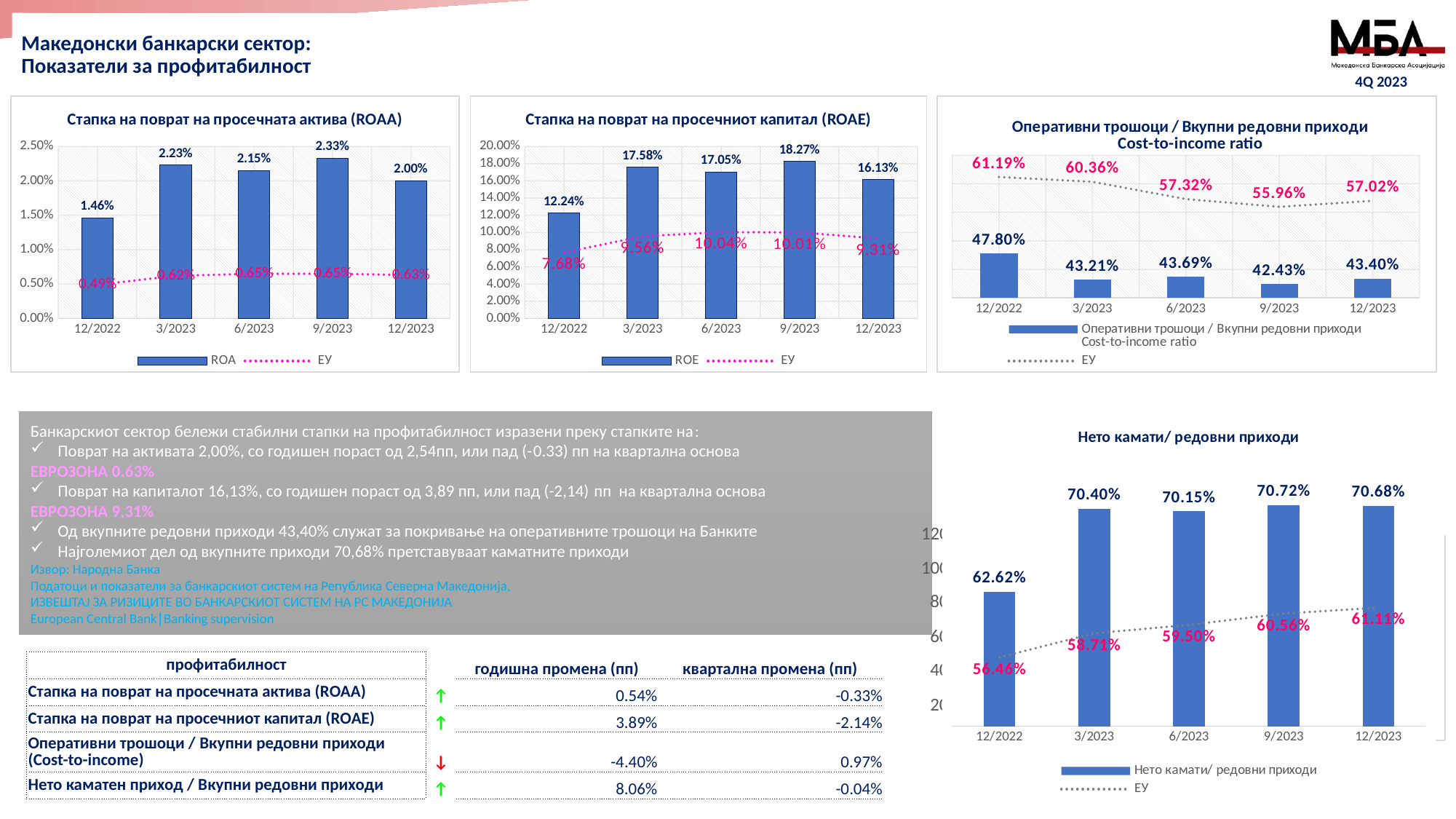
In the Cost-to-income ratio chart, what is the EU (ЕУ) value for 9/2023? 55.96% In the ROAE chart, what is the difference between the ROE value for 9/2023 and the ROE value for 12/2023? 2.14 percentage points How many periods are shown on the x axis of the ROAA chart? 5 How many series does the legend of the ROAE chart list? 2 In the ROAA chart (Стапка на поврат на просечната актива), what is the ROA value for 12/2023? 2.00% In the ROAE chart (Стапка на поврат на просечниот капитал), what is the ROE value for 3/2023? 17.58% In the Cost-to-income ratio chart, which is larger for 12/2022: the bank sector bar value or the EU value? the EU value (61.19%) In the ROAA chart, what is the EU (ЕУ) value for 12/2022? 0.49% In the ROAE chart, which period has the lowest ROE value? 12/2022 In the Нето камати/ редовни приходи chart, does the EU (ЕУ) dotted line rise or fall from 12/2022 to 12/2023? rise In the ROAA chart, which period has the highest ROA value? 9/2023 In the Нето камати/ редовни приходи chart, what is the bar value for 9/2023? 70.72%